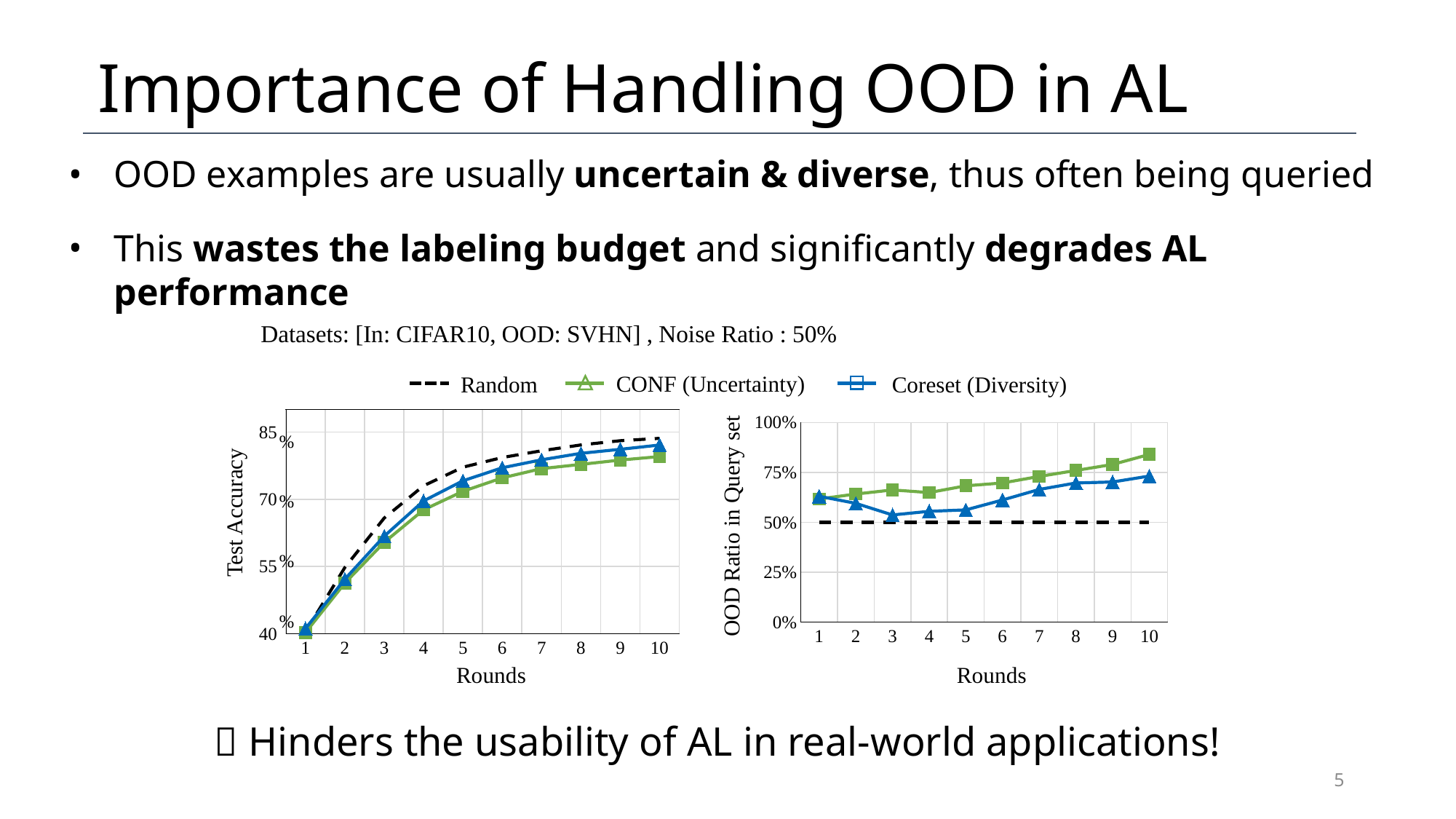
How many series does the legend list? 3 In the right chart (OOD Ratio in Query set), at what value does the Random dashed line sit? 50% What kind of chart is the left chart (Test Accuracy vs Rounds)? line chart What is the label of the y axis of the right chart? OOD Ratio in Query set In the left chart (Test Accuracy), is the value for Coreset (Diversity) at round 10 greater or less than 70%? greater In the right chart (OOD Ratio in Query set), which series has the highest value at round 10? CONF (Uncertainty) In the left chart (Test Accuracy), is the value for CONF (Uncertainty) at round 1 greater or less than 55%? less In the left chart (Test Accuracy), how many rounds are plotted on the x axis? 10 In the left chart (Test Accuracy), which series has the lowest value at round 10? CONF (Uncertainty) In the left chart (Test Accuracy), do the values rise or fall as the rounds increase? rise In the left chart (Test Accuracy), which series has the highest value at round 10? Random In the right chart (OOD Ratio in Query set), is the value for CONF (Uncertainty) at round 10 greater or less than 75%? greater